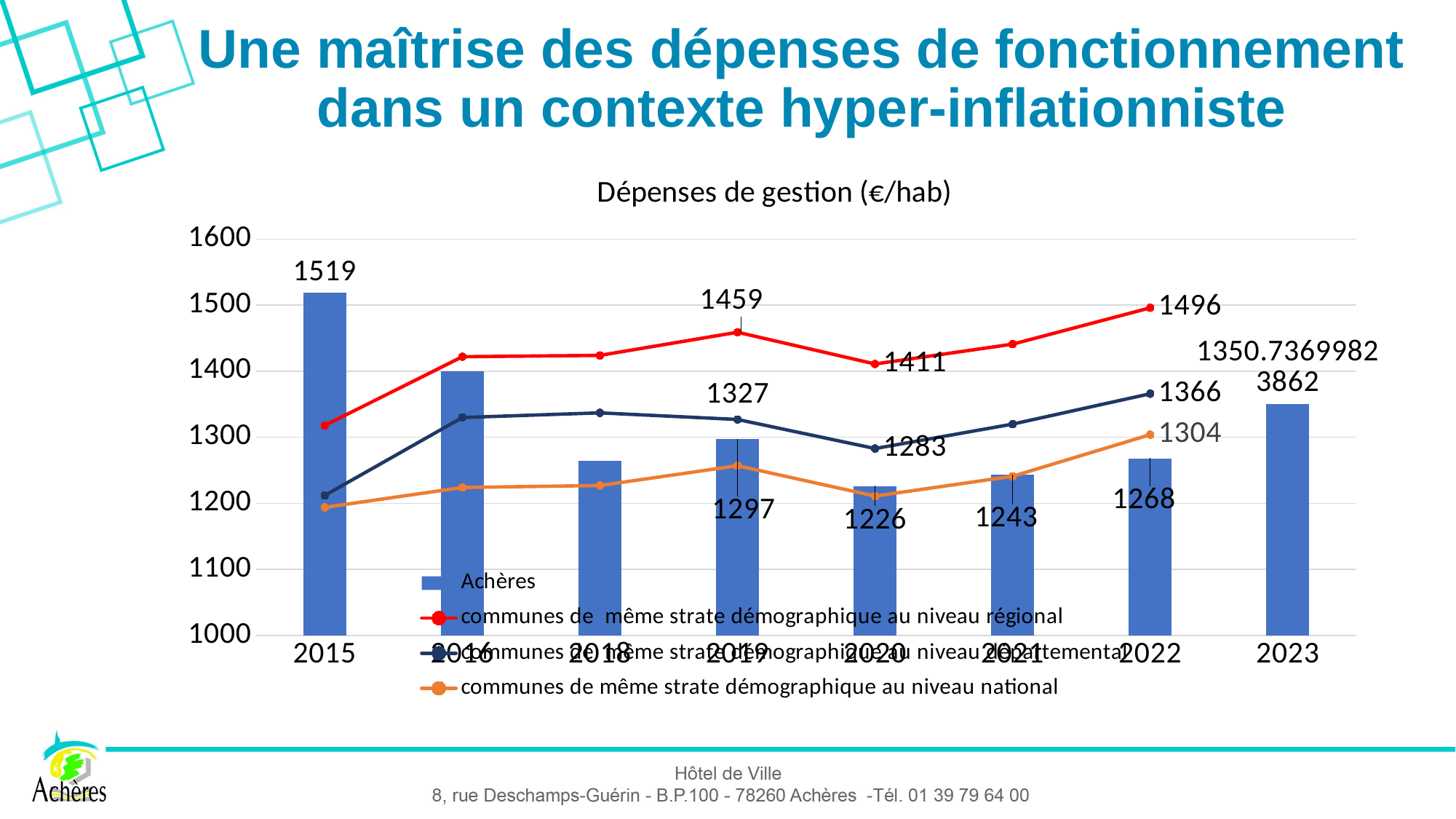
What is the 2019 value for communes de même strate démographique au niveau départemental? 1327 What is the 2022 value for communes de même strate démographique au niveau national? 1304 Is the Achères value for 2016 greater or less than 1300? greater What is the value of the Achères bar for 2015? 1519 In 2022, which is larger: the regional series value or the départemental series value? communes de même strate démographique au niveau régional What is the difference between the Achères values for 2015 and 2022? 251 What is the 2022 value for communes de même strate démographique au niveau régional? 1496 How many series does the legend list? 4 In which year is the Achères bar the lowest? 2020 How many years are shown on the x axis? 8 In which year is the Achères bar the highest? 2015 What is the value of the Achères bar for 2020? 1226